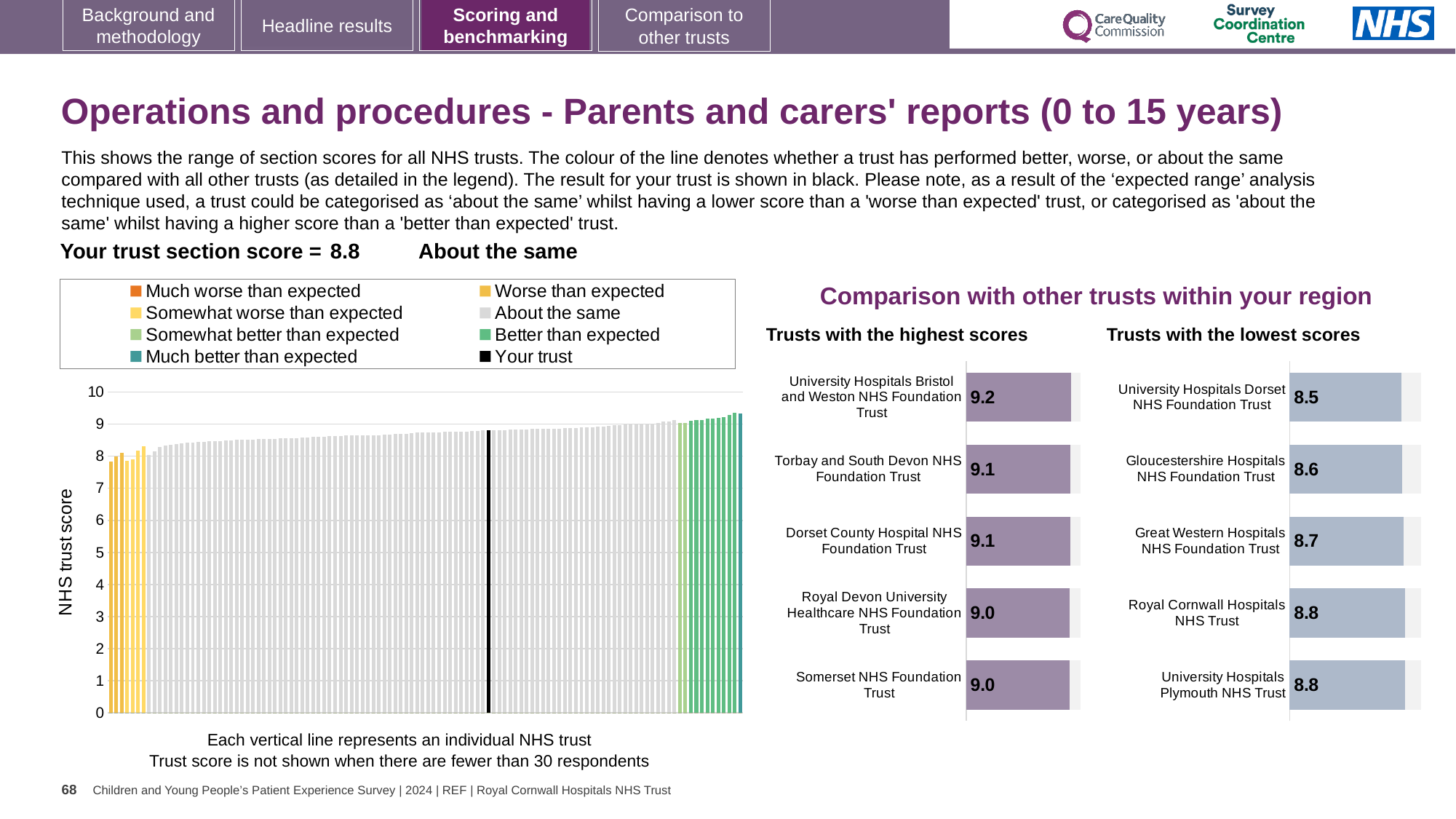
In the 'Trusts with the lowest scores' chart, what is the score for Royal Cornwall Hospitals NHS Trust? 8.8 How many trusts are shown in the 'Trusts with the lowest scores' chart? 5 In the 'Trusts with the highest scores' chart, what is the score for Somerset NHS Foundation Trust? 9.0 In the 'Trusts with the lowest scores' chart, which trust has the lowest score? University Hospitals Dorset NHS Foundation Trust In the 'Trusts with the highest scores' chart, what is the score for University Hospitals Bristol and Weston NHS Foundation Trust? 9.2 In the 'Trusts with the highest scores' chart, what is the difference between the scores of University Hospitals Bristol and Weston NHS Foundation Trust and Somerset NHS Foundation Trust? 0.2 What kind of chart is the 'NHS trust score' chart on the left of the slide? Bar chart In the 'NHS trust score' chart on the left, do the bar values rise or fall from left to right? Rise In the 'Trusts with the lowest scores' chart, which has the larger score: Gloucestershire Hospitals NHS Foundation Trust or Great Western Hospitals NHS Foundation Trust? Great Western Hospitals NHS Foundation Trust In the 'Trusts with the lowest scores' chart, what is the difference between the scores of Great Western Hospitals NHS Foundation Trust and University Hospitals Dorset NHS Foundation Trust? 0.2 In the 'Trusts with the highest scores' chart, which trust has the highest score? University Hospitals Bristol and Weston NHS Foundation Trust How many entries does the legend of the 'NHS trust score' chart on the left list? 8